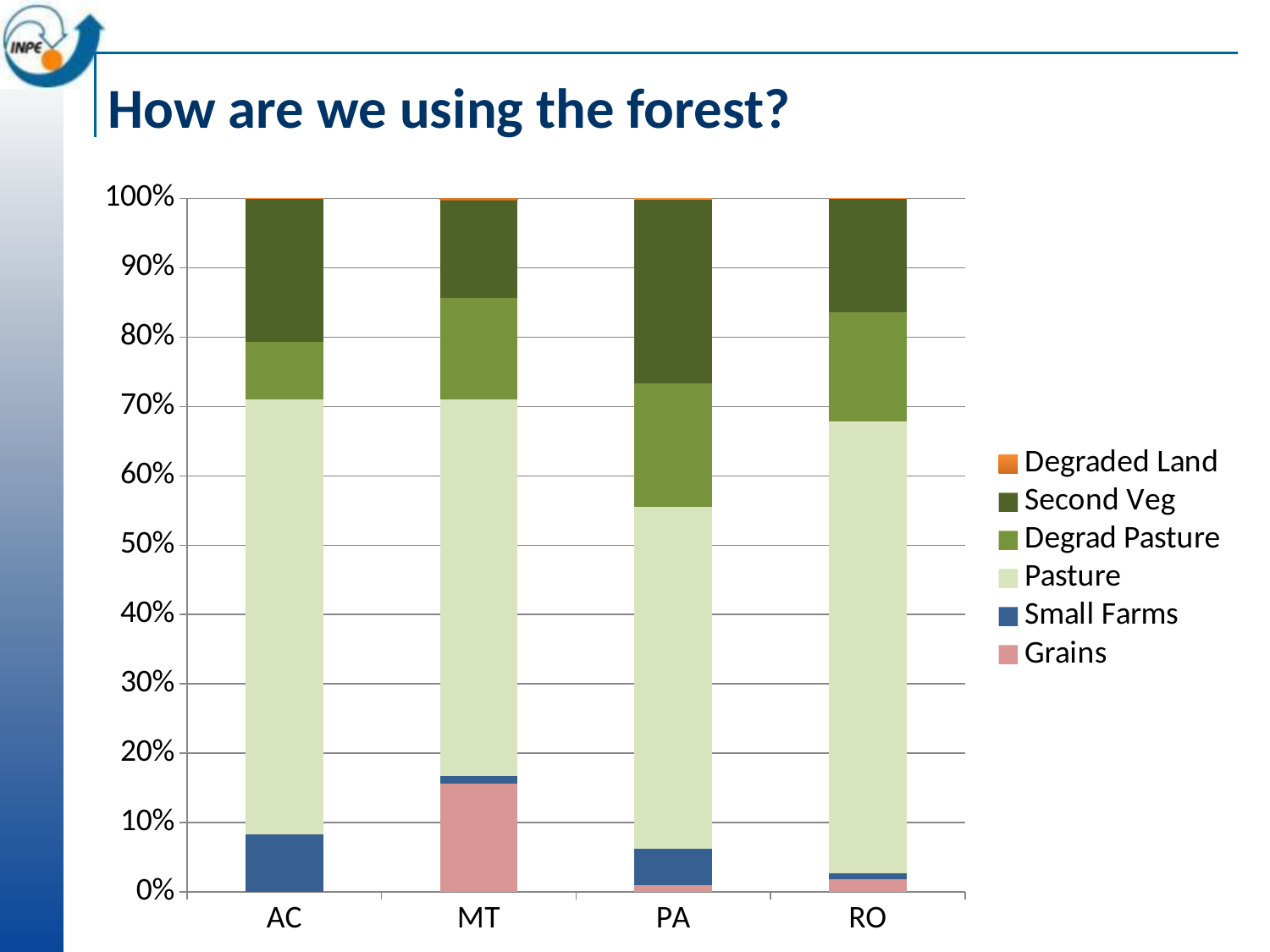
Which state has the largest Grains share? MT Which state has the largest Second Veg share? PA Is the Second Veg share for MT greater or less than 20%? less How many states (categories) are shown on the x axis? 4 Which series is shown in the lightest green colour? Pasture Is the Second Veg share for PA greater or less than 20%? greater How many series does the legend list? 6 Is the Grains share for MT greater or less than 10%? greater Which is larger: the Small Farms share for AC or for RO? AC Which state has the largest Small Farms share? AC What kind of chart is shown on the slide? Stacked bar chart What is the title of the slide containing the chart? How are we using the forest?